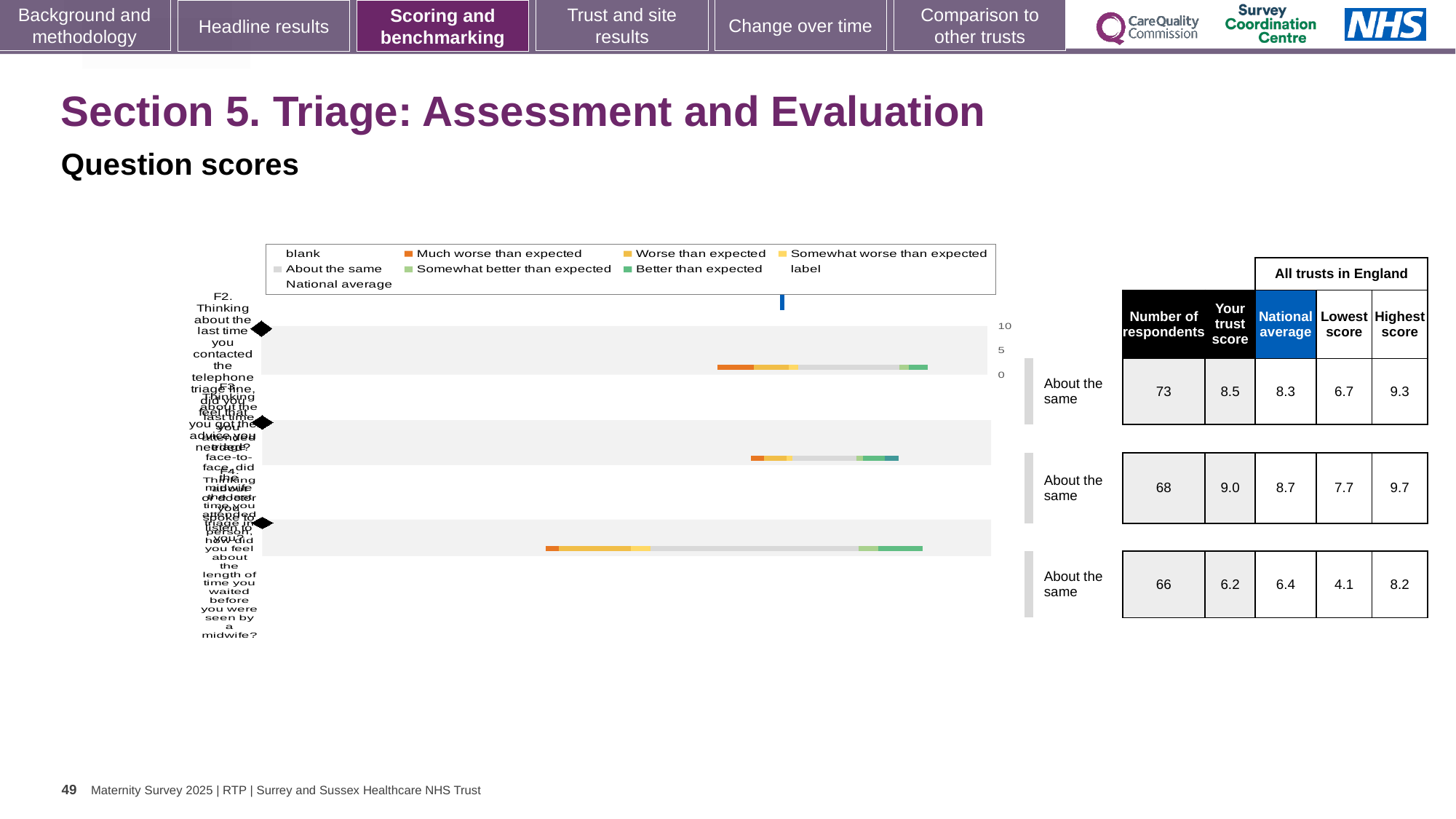
What is the lowest score across all trusts in England for question F4? 4.1 What is the trust score for question F2 in the table next to the chart? 8.5 How many questions (categories) are plotted in the chart? 3 Which question has the lowest trust score? F4 For question F4, which is larger: the trust score or the national average? National average What is the difference between the trust score and the national average for question F2? 0.2 What is the national average for question F3? 8.7 How many respondents answered question F4? 66 Which question has the highest trust score? F3 What is the highest score across all trusts in England for question F3? 9.7 What kind of chart is shown on the slide? bar chart What benchmark category is shown for all three questions in the chart? About the same